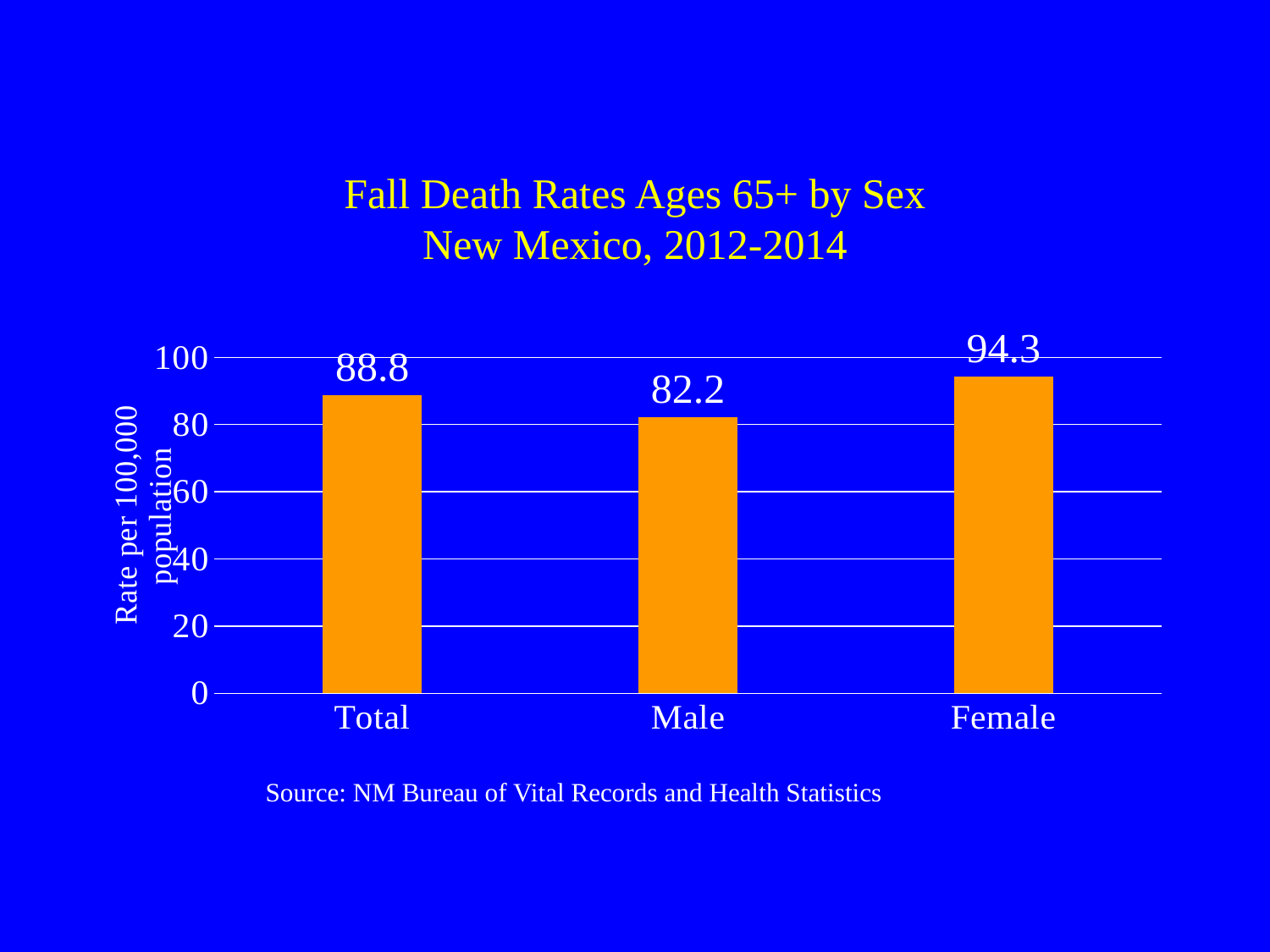
How many categories are shown on the x axis? 3 What is the difference between the Total and Male fall death rates? 6.6 Which category has the lowest fall death rate? Male What is the fall death rate for Male? 82.2 What kind of chart is shown on the slide? bar chart What is the difference between the Female and Male fall death rates? 12.1 Which category has the highest fall death rate? Female What is the fall death rate for Female? 94.3 What is the title of the chart? Fall Death Rates Ages 65+ by Sex New Mexico, 2012-2014 What is the fall death rate for Total? 88.8 Which is larger, the fall death rate for Male or for Female? Female Is the value for Male greater or less than 80? greater